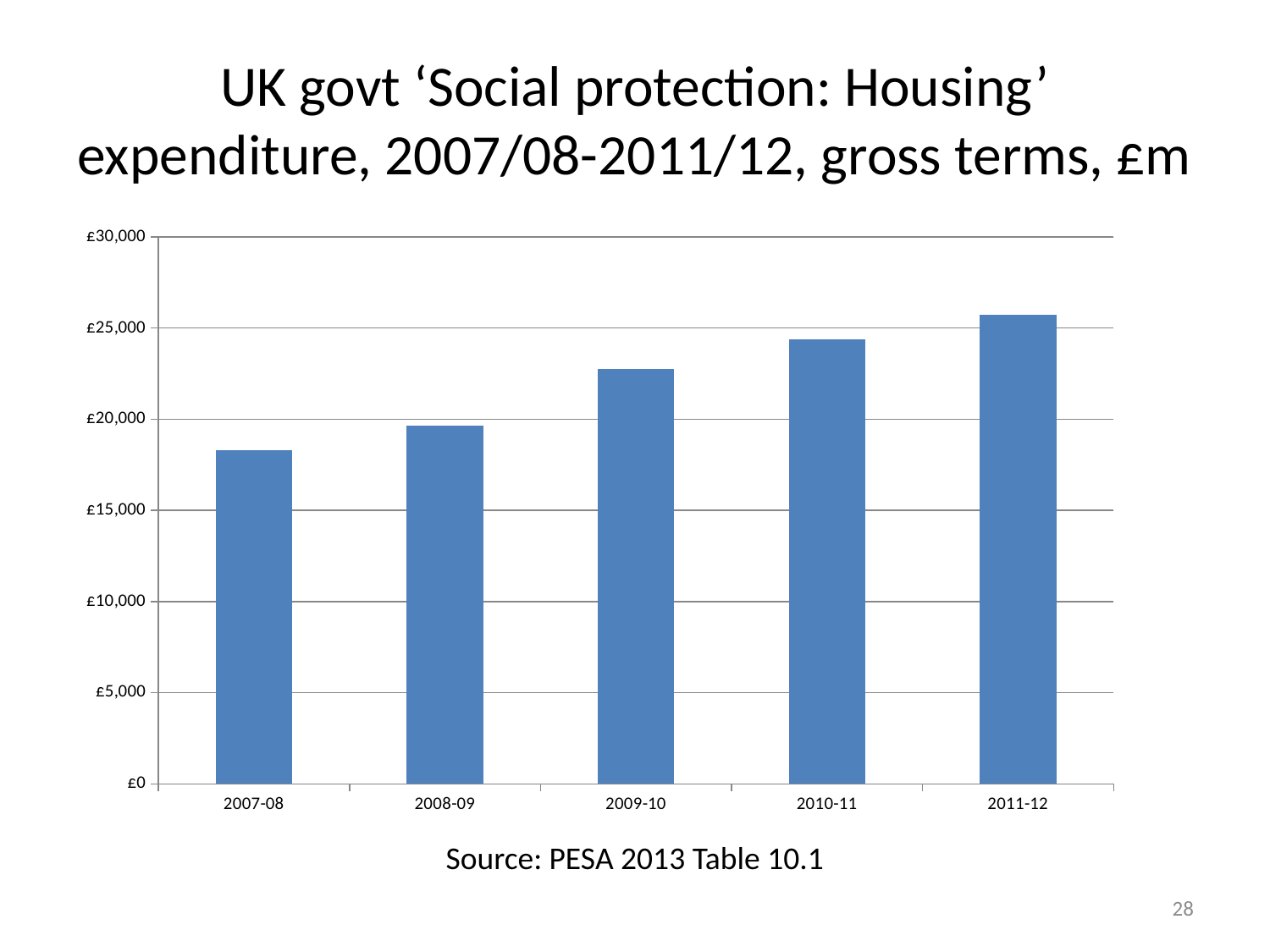
Is the value for 2007-08 greater or less than £20,000? less Is the value for 2008-09 greater or less than £20,000? less How many years are plotted on the chart? 5 Is the value for 2011-12 greater or less than £25,000? greater Which year has the highest expenditure? 2011-12 Which is larger, the value for 2008-09 or the value for 2010-11? 2010-11 Do the values rise or fall from 2007-08 to 2011-12? rise What source is cited below the chart? PESA 2013 Table 10.1 What kind of chart is shown on the slide? bar chart Which year has the lowest expenditure? 2007-08